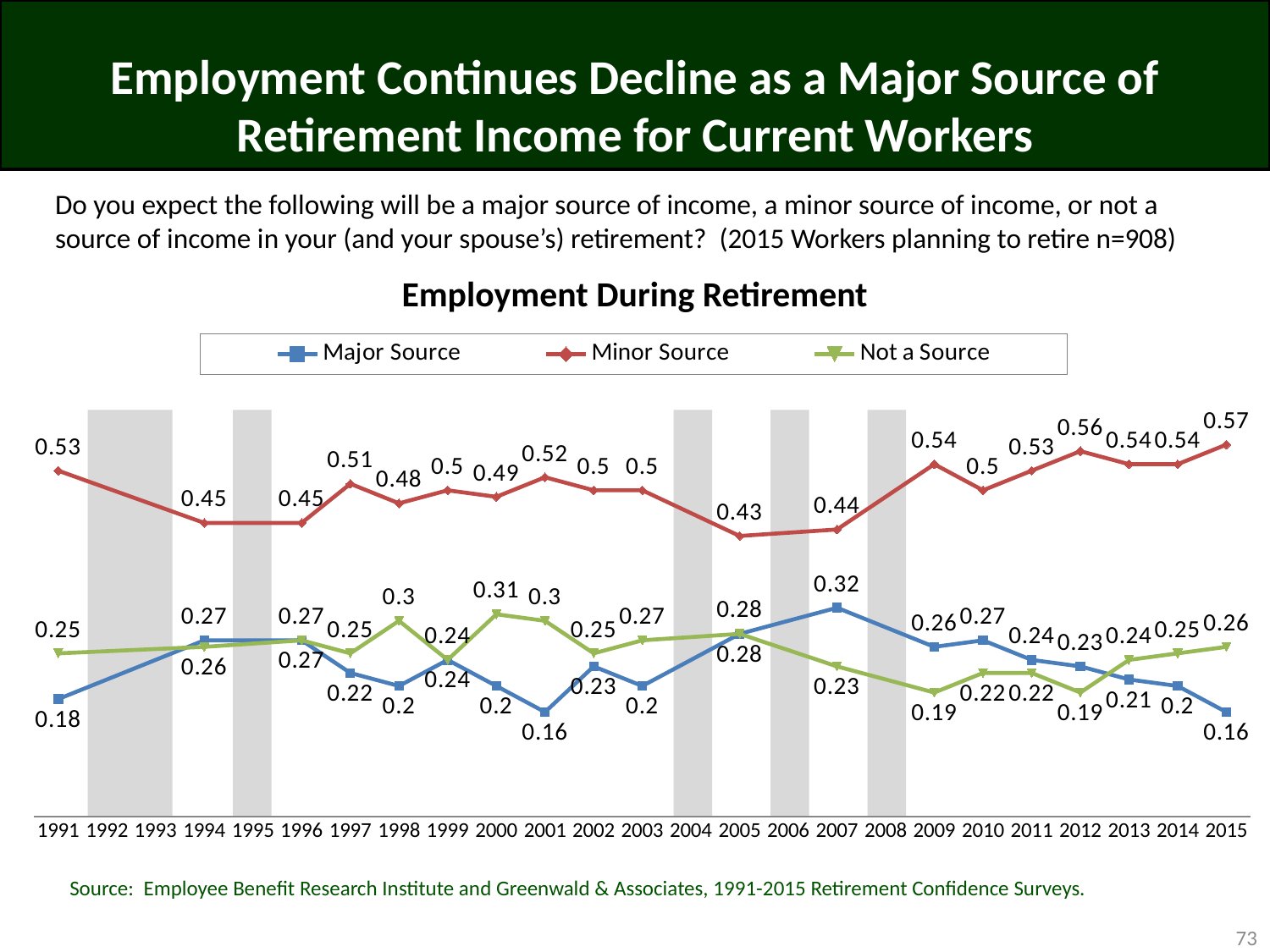
In which year is the Minor Source value lowest? 2005 What is the difference between the Major Source value in 2007 and in 2015? 0.16 How many series does the legend list? 3 What is the value for Minor Source in 2015? 0.57 What kind of chart is shown on the slide? line chart In which year is the Major Source value highest? 2007 What is the value for Not a Source in 2000? 0.31 What is the value for Minor Source in 2012? 0.56 In 2015, which is larger: Not a Source or Major Source? Not a Source In which year is the Minor Source value highest? 2015 What is the value for Major Source in 1991? 0.18 Does the Major Source line rise or fall from 2007 to 2015? fall